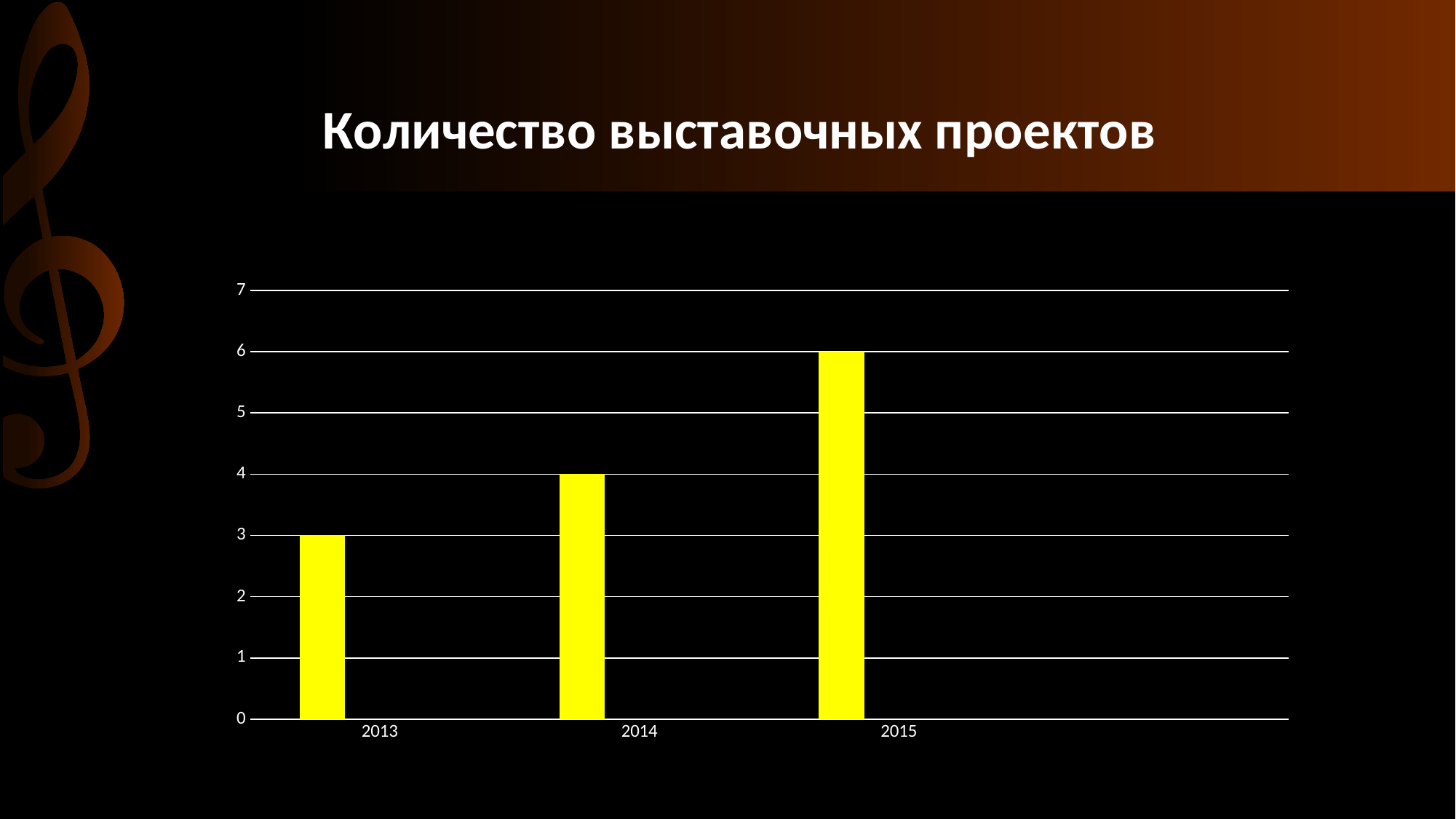
What is the value for 2015? 6 Is the value for 2015 greater or less than 5? greater What kind of chart is shown on the slide? bar chart Do the values rise or fall from 2013 to 2015? rise What is the difference between the values for 2014 and 2013? 1 What is the value for 2013? 3 What is the value for 2014? 4 How many years are shown on the x axis? 3 Which year has the highest value? 2015 Which year has the lowest value? 2013 Which is larger, the value for 2014 or the value for 2015? 2015 What is the difference between the values for 2015 and 2013? 3